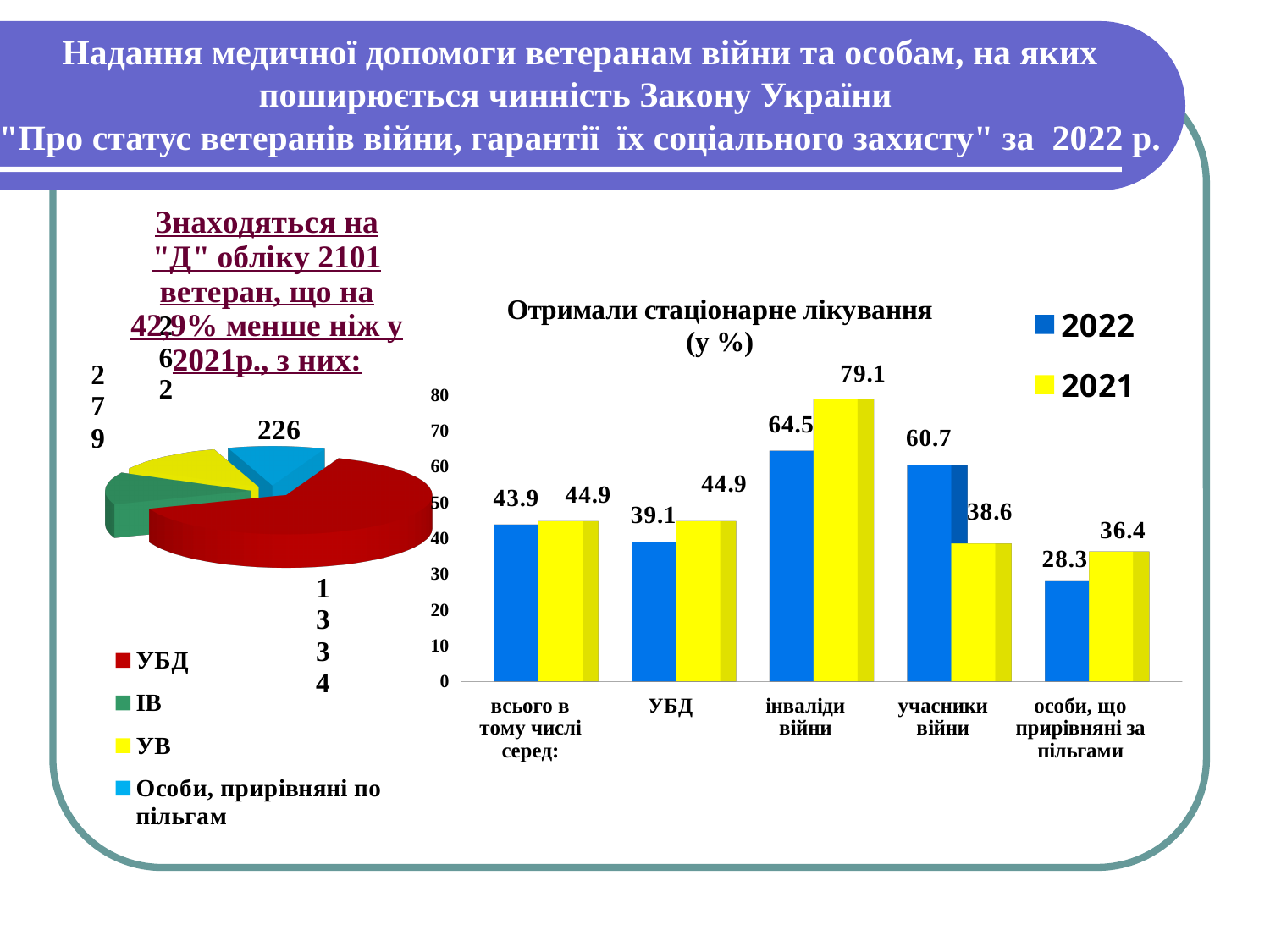
In the bar chart 'Отримали стаціонарне лікування (у %)', which category has the highest 2021 value? інваліди війни In the bar chart 'Отримали стаціонарне лікування (у %)', how many categories are shown on the x axis? 5 In the bar chart 'Отримали стаціонарне лікування (у %)', for учасники війни, which year has the larger value, 2022 or 2021? 2022 In the bar chart 'Отримали стаціонарне лікування (у %)', what is the difference between the 2021 and 2022 values for інваліди війни? 14.6 In the bar chart 'Отримали стаціонарне лікування (у %)', how many series does the legend list? 2 In the pie chart on the left, which category has the largest slice? УБД In the bar chart 'Отримали стаціонарне лікування (у %)', what is the 2022 value for інваліди війни? 64.5 What kind of chart is the chart on the left side of the slide? pie chart In the bar chart 'Отримали стаціонарне лікування (у %)', what is the 2021 value for учасники війни? 38.6 In the bar chart 'Отримали стаціонарне лікування (у %)', which category has the lowest 2022 value? особи, що прирівняні за пільгами In the bar chart 'Отримали стаціонарне лікування (у %)', what is the 2022 value for особи, що прирівняні за пільгами? 28.3 In the pie chart on the left, what is the value for УБД? 1334